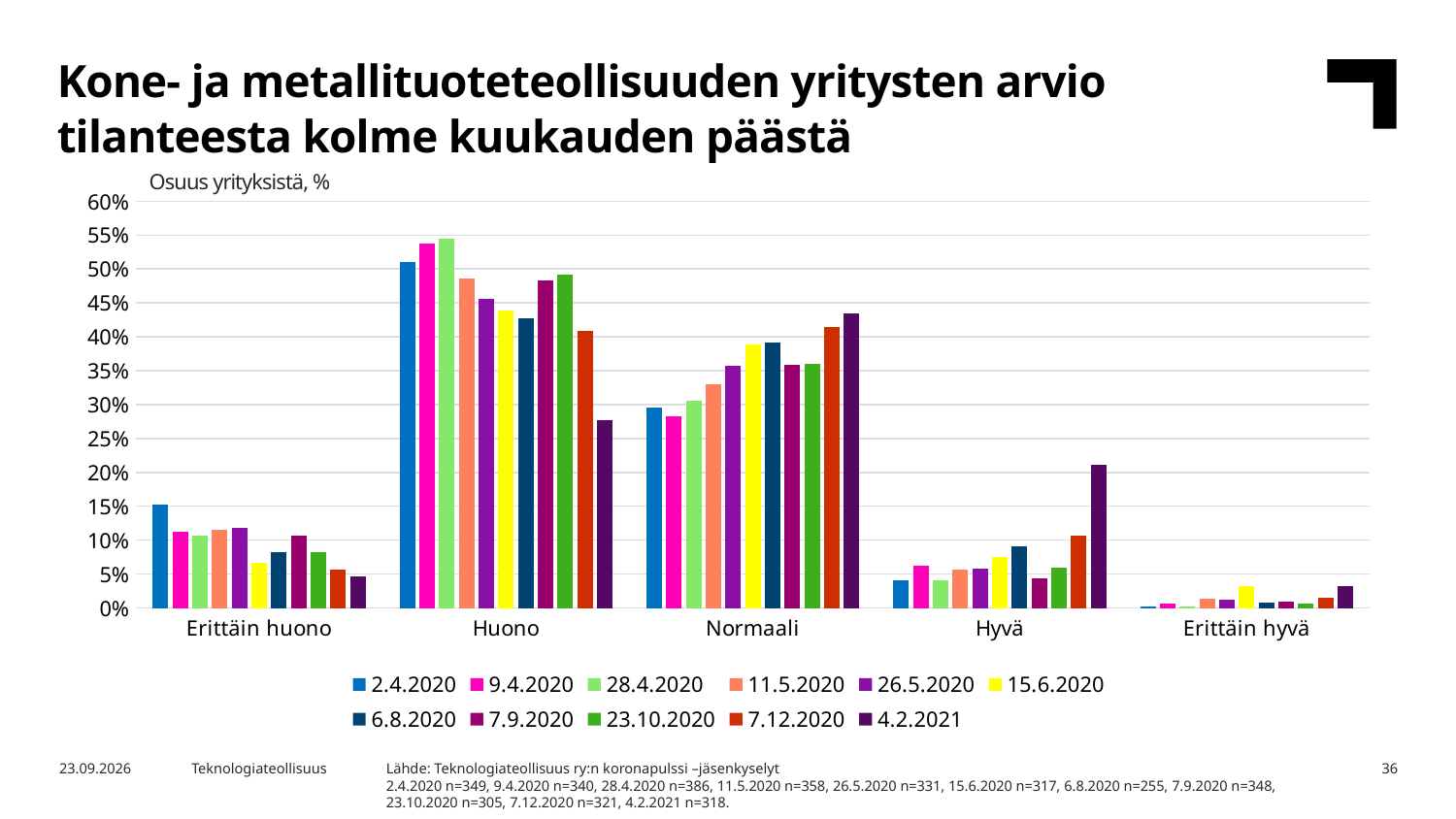
How many series does the legend list? 11 For the 4.2.2021 series, which is larger: the value for Huono or the value for Normaali? Normaali Is the value for 4.2.2021 in the Huono category greater or less than 30%? less Is the value for 2.4.2020 in the Erittäin huono category greater or less than 10%? greater What is the label shown above the y axis of the chart? Osuus yrityksistä, % In the Normaali category, which series has the highest value? 4.2.2021 Is the value for 4.2.2021 in the Hyvä category greater or less than 15%? greater In the Hyvä category, which series has the highest value? 4.2.2021 What kind of chart is shown on the slide? bar chart How many categories are shown on the x axis of the chart? 5